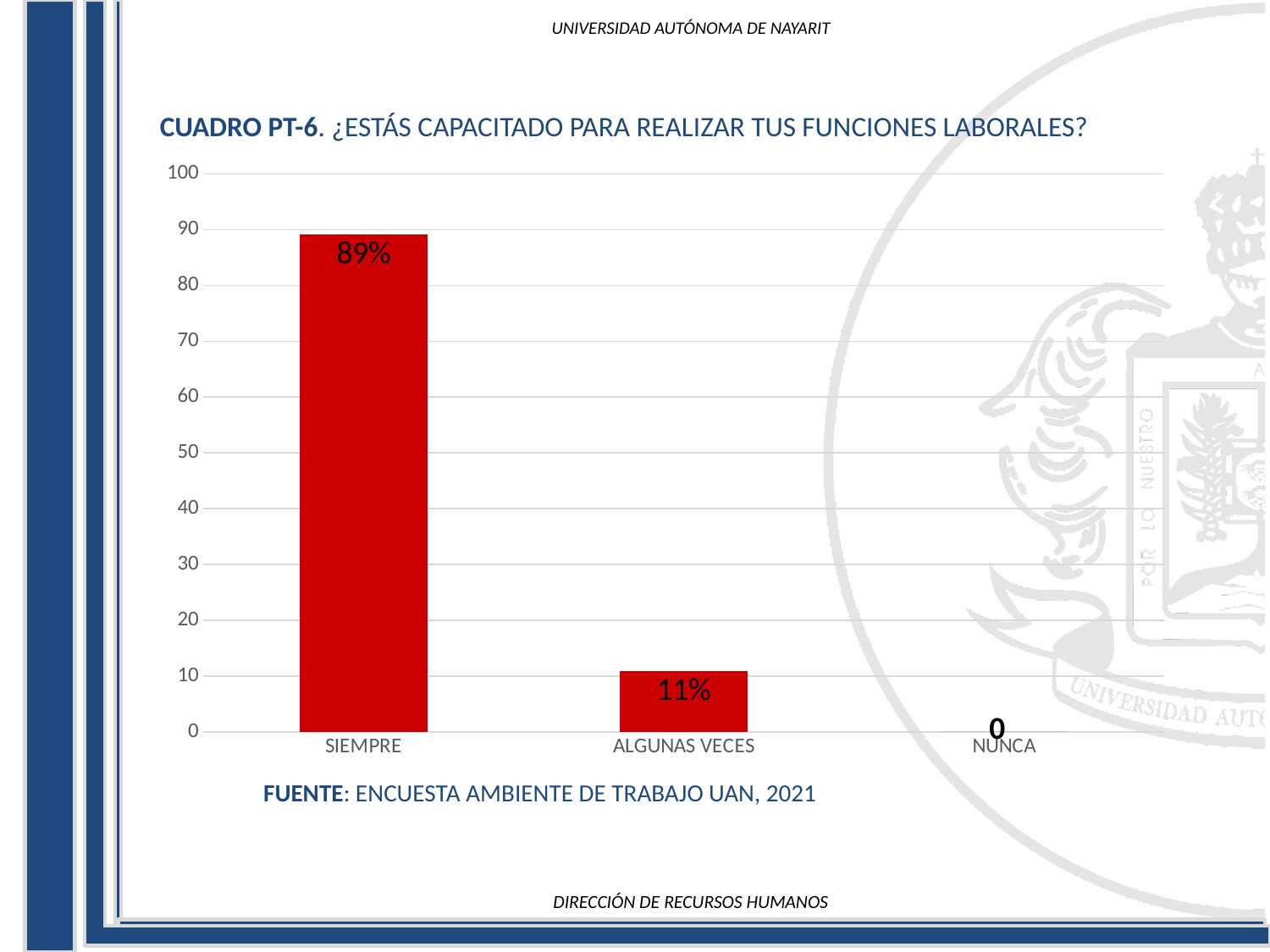
Which is larger, the value for SIEMPRE or the value for ALGUNAS VECES? SIEMPRE What is the difference between the values for SIEMPRE and ALGUNAS VECES? 78% Which category has the lowest value? NUNCA What is the value for SIEMPRE? 89% What kind of chart is shown on the slide? bar chart How many categories are shown on the x axis? 3 Which category has the highest value? SIEMPRE What is the value for NUNCA? 0 Is the value for ALGUNAS VECES greater or less than 20? less What source is cited below the chart? ENCUESTA AMBIENTE DE TRABAJO UAN, 2021 Is the value for SIEMPRE greater or less than 80? greater What is the value for ALGUNAS VECES? 11%